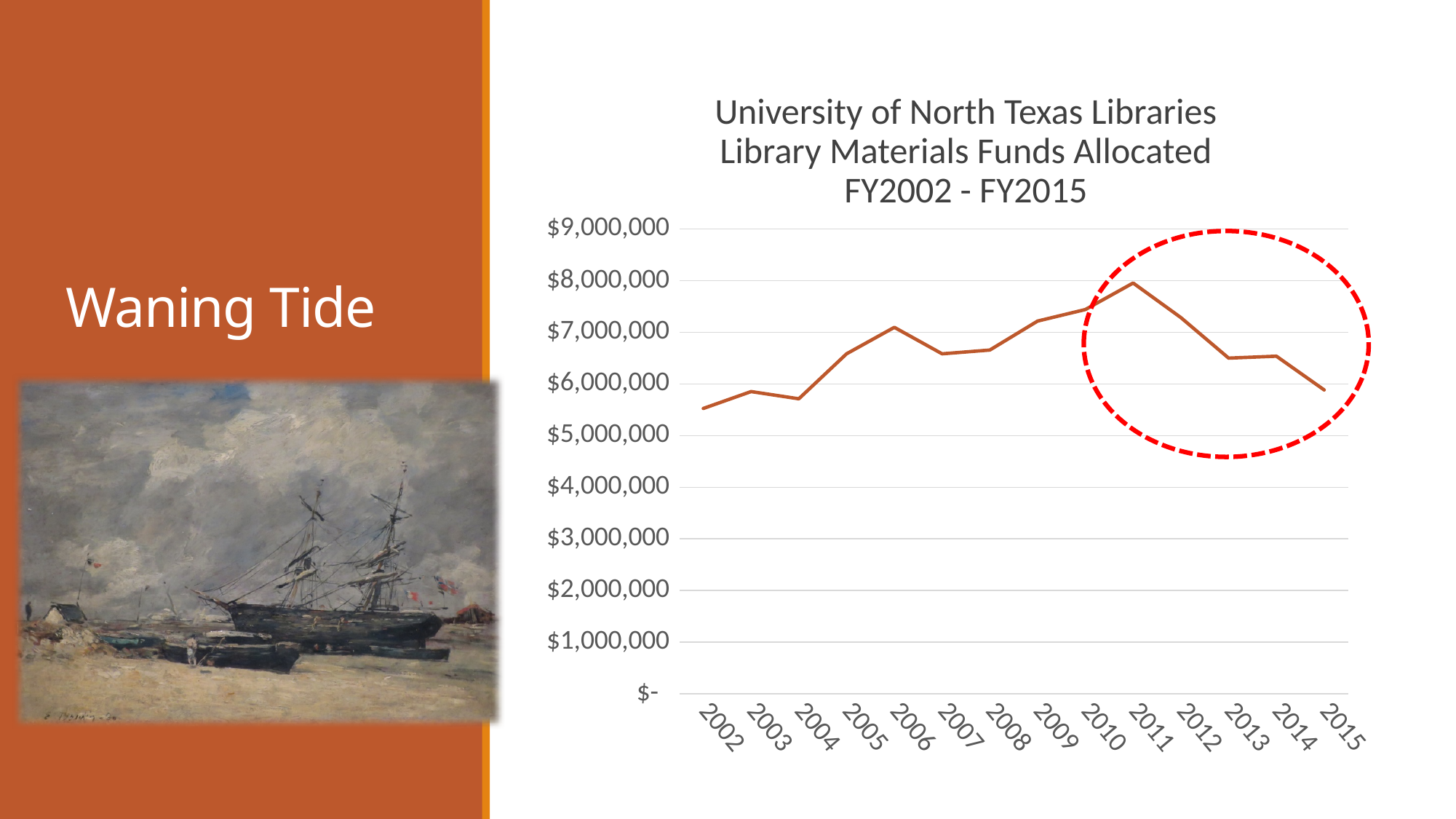
What is the title of the chart? University of North Texas Libraries Library Materials Funds Allocated FY2002 - FY2015 Which year has the larger value, 2006 or 2007? 2006 Do the values rise or fall from 2011 to 2015? fall Is the value for 2011 greater or less than $7,000,000? greater How many fiscal years are plotted on the x axis of the chart? 14 Is the value for 2002 greater or less than $6,000,000? less Which year has the larger value, 2011 or 2015? 2011 Is the value for 2013 greater or less than $7,000,000? less Which year has the highest library materials funds allocated? 2011 What kind of chart is shown on the slide? Line chart